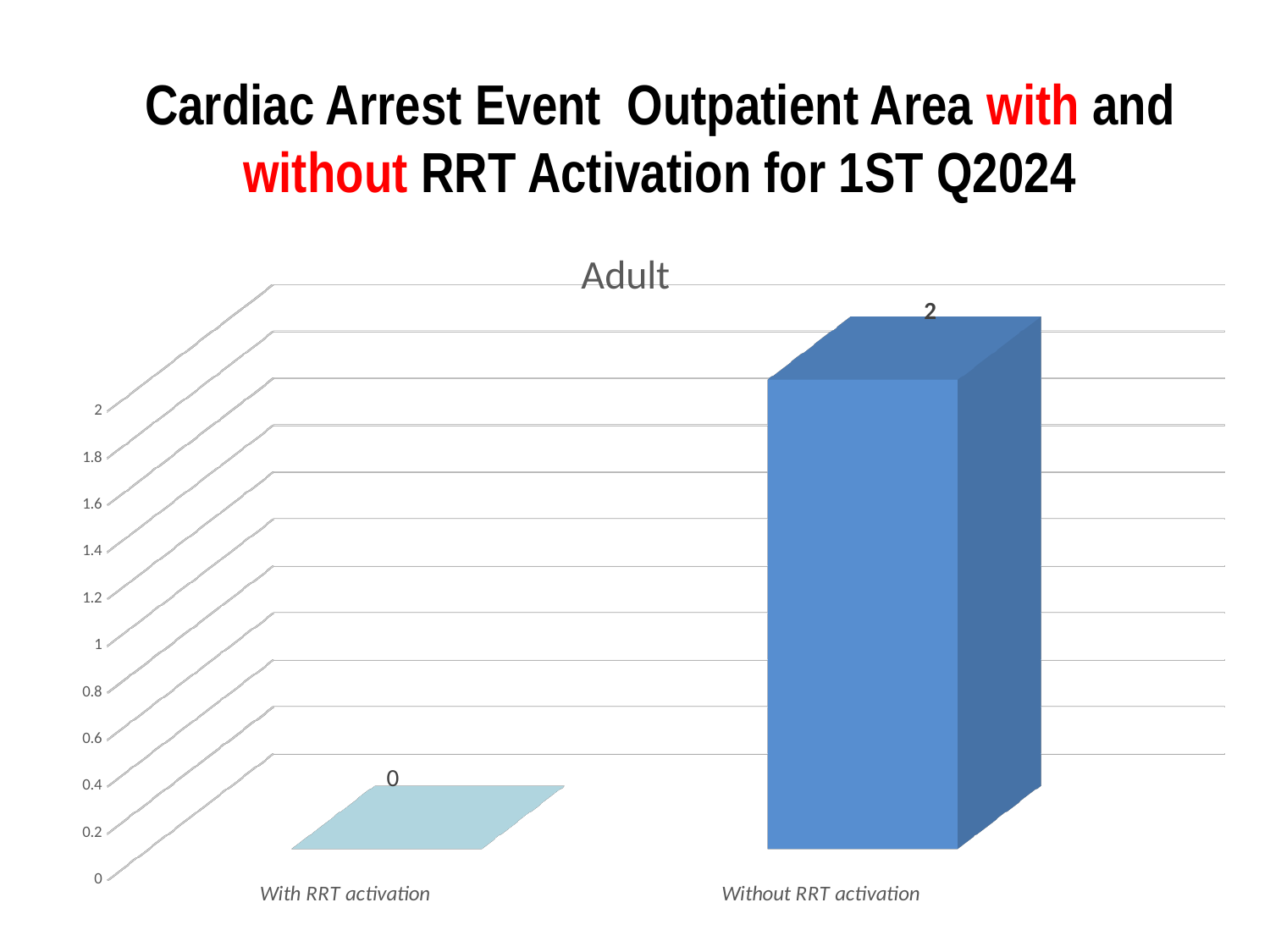
What kind of chart is shown on the slide? bar chart Which category has the highest value? Without RRT activation Which is larger, the value for "With RRT activation" or "Without RRT activation"? Without RRT activation How many categories are shown on the x axis? 2 What is the title of the chart? Adult Which category has the lowest value? With RRT activation What is the value for "With RRT activation"? 0 What is the difference between the values for "Without RRT activation" and "With RRT activation"? 2 What is the highest value shown on the vertical axis? 2 Is the value for "Without RRT activation" greater or less than 1? greater What is the value for "Without RRT activation"? 2